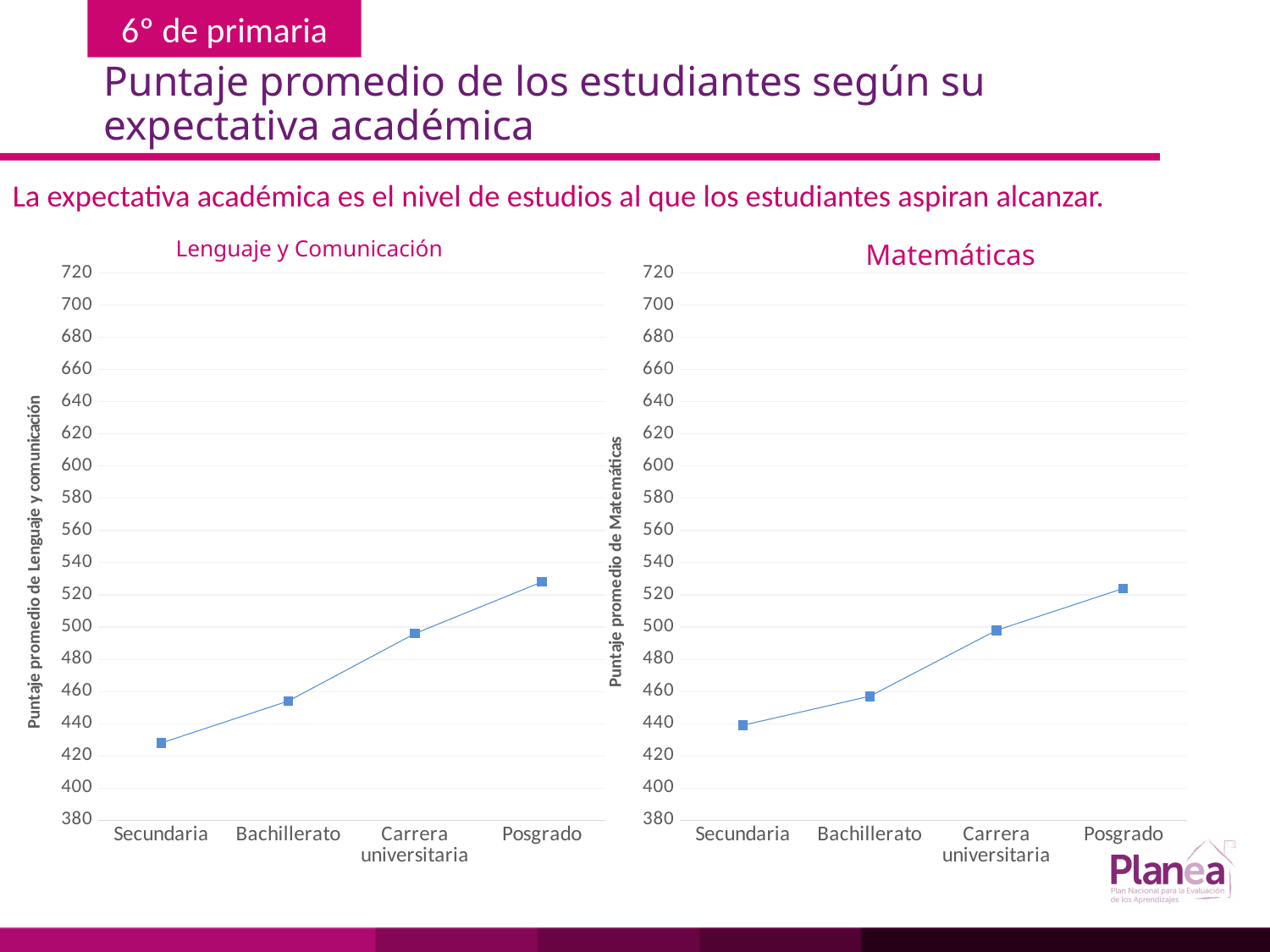
In the Matemáticas chart, is the value for Bachillerato greater or less than 480? less In the Lenguaje y Comunicación chart, which category has the lowest average score? Secundaria In the Matemáticas chart, which category has the highest average score? Posgrado In the Lenguaje y Comunicación chart, what kind of chart is shown? line chart What is the y-axis label of the chart on the left side of the slide? Puntaje promedio de Lenguaje y comunicación In the Matemáticas chart, is the value for Carrera universitaria greater or less than 480? greater In the Matemáticas chart, is the value for Posgrado greater or less than 500? greater In the Lenguaje y Comunicación chart, which is larger, the value for Bachillerato or the value for Carrera universitaria? Carrera universitaria What is the title of the chart on the right side of the slide? Matemáticas In the Matemáticas chart, how many categories are plotted on the x axis? 4 In the Lenguaje y Comunicación chart, do the values rise or fall from Secundaria to Posgrado? rise